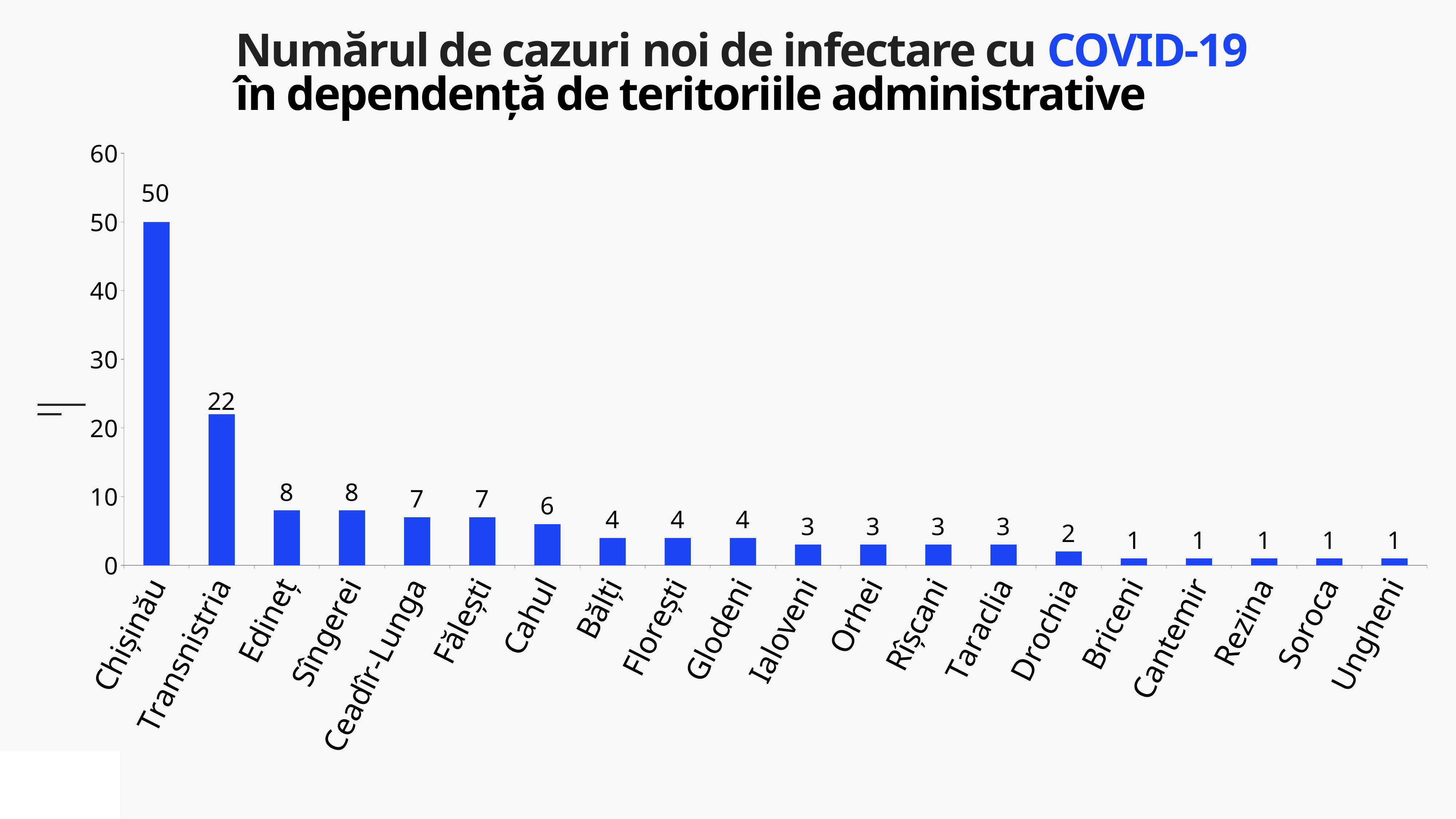
What is the value shown for Drochia? 2 Do the values rise or fall from left to right along the x axis? Fall Is the value for Transnistria greater or less than 20? greater What kind of chart is shown on the slide? Bar chart What is the number of new cases for Chișinău? 50 What is the difference between the values for Chișinău and Transnistria? 28 What is the difference between the values for Edineț and Bălți? 4 What is the number of new cases for Transnistria? 22 Which administrative territory has the highest number of new cases? Chișinău What is the value shown for Cahul? 6 How many administrative territories are shown on the x axis? 20 Which has a larger value, Fălești or Glodeni? Fălești